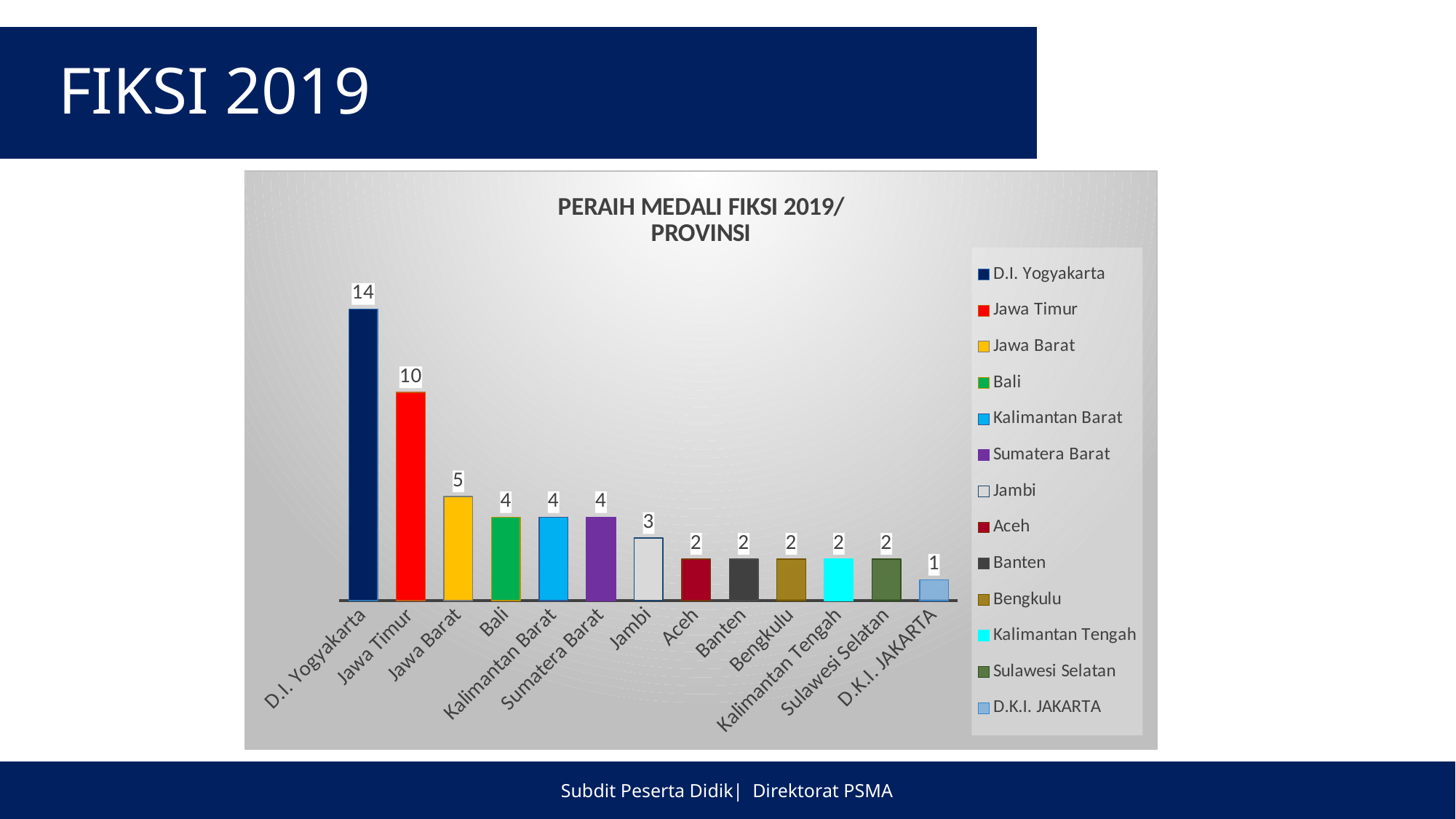
How many provinces are shown on the x axis? 13 What kind of chart is this? Bar chart Which province has the lowest value? D.K.I. JAKARTA What is the value for D.K.I. JAKARTA? 1 What is the value for D.I. Yogyakarta? 14 What is the value for Jambi? 3 What is the value for Jawa Timur? 10 What is the title of the chart? PERAIH MEDALI FIKSI 2019/ PROVINSI Which is larger, the value for Bali or the value for Aceh? Bali What is the difference between the values for D.I. Yogyakarta and Jawa Timur? 4 Which province has the highest value? D.I. Yogyakarta What is the difference between the values for Jawa Barat and Jambi? 2